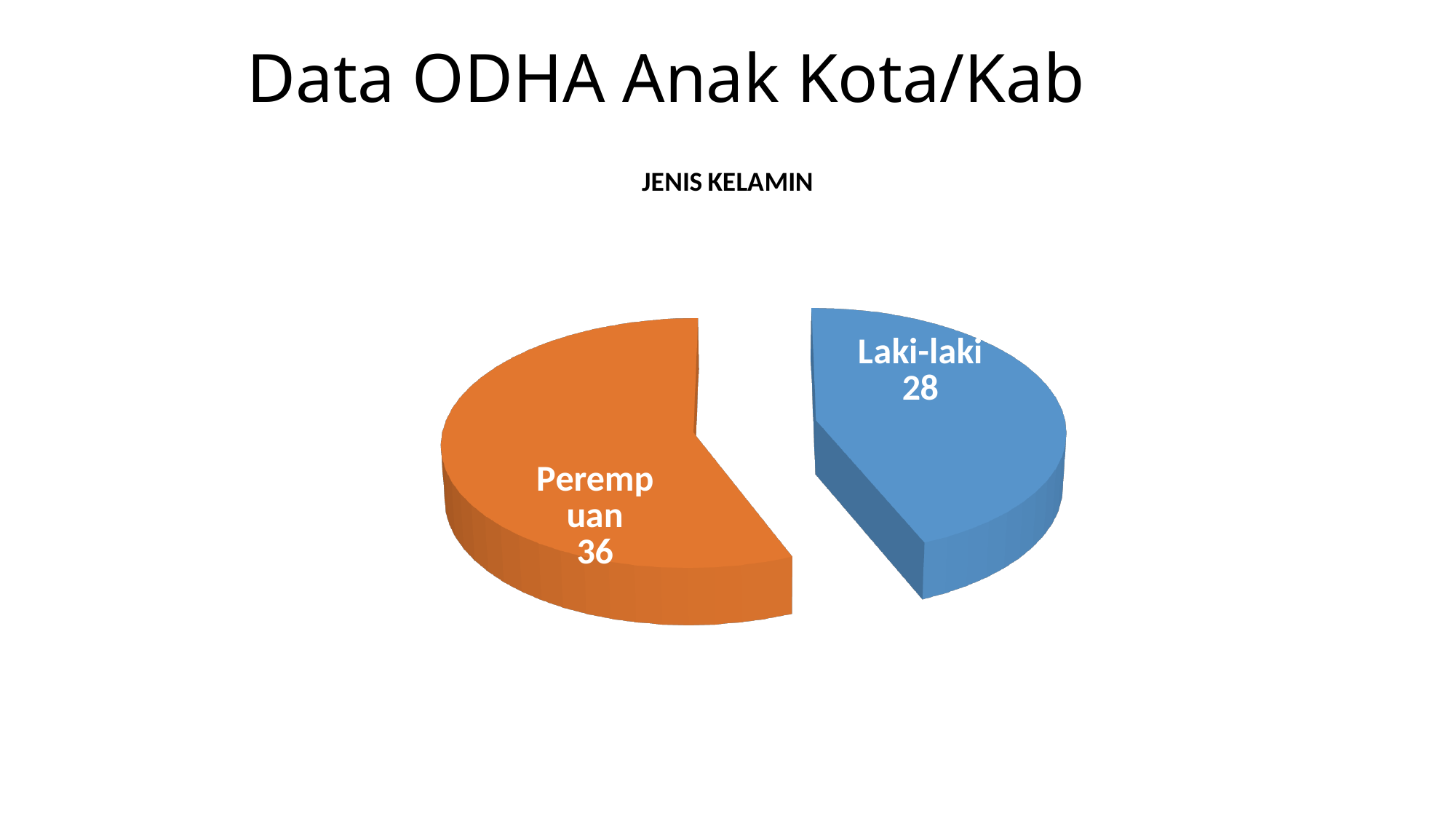
Which category has the smallest slice in the JENIS KELAMIN pie chart? Laki-laki What is the value for Laki-laki in the JENIS KELAMIN pie chart? 28 What is the difference between the Perempuan and Laki-laki values in the JENIS KELAMIN pie chart? 8 What is the title of the chart on the slide? JENIS KELAMIN What is the total of the two slices in the JENIS KELAMIN pie chart? 64 What kind of chart is shown on the slide? Pie chart What is the value for Perempuan in the JENIS KELAMIN pie chart? 36 Which category has the largest slice in the JENIS KELAMIN pie chart? Perempuan How many slices does the JENIS KELAMIN pie chart have? 2 Which is larger in the JENIS KELAMIN pie chart, Laki-laki or Perempuan? Perempuan What colour is the Laki-laki slice in the JENIS KELAMIN pie chart? Blue